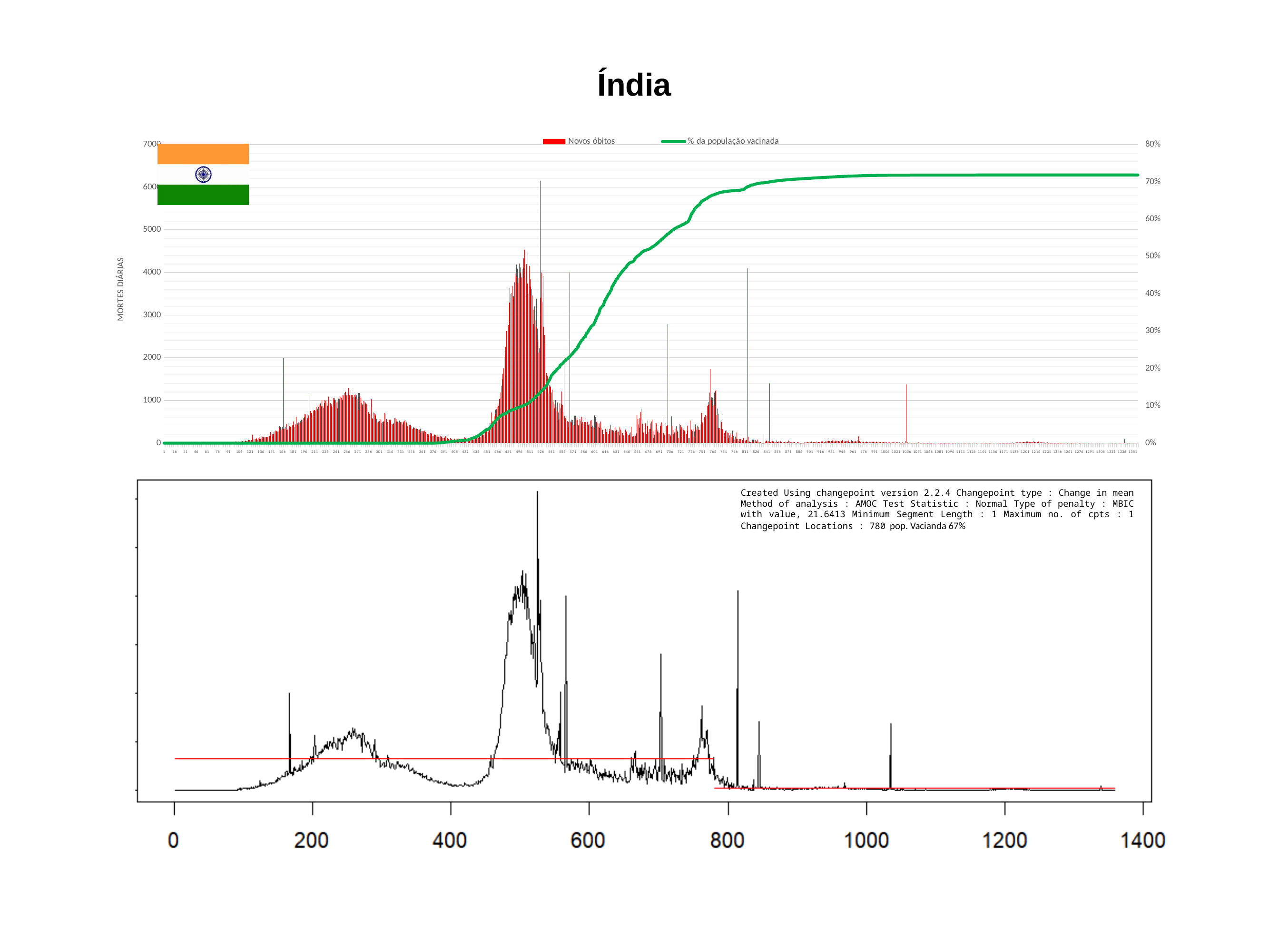
On the bottom chart, what penalty value is reported in the text box? 21.6413 On the top chart, what are the two legend entries? Novos óbitos; % da população vacinada On the bottom chart, what is the highest value shown on the horizontal axis? 1400 On the bottom chart, what percentage of the population is reported as vaccinated in the text box? 67% On the bottom chart, what changepoint location is reported in the text box? 780 On the top chart, what is the title of the left vertical axis? MORTES DIÁRIAS On the top chart, is the final value of the '% da população vacinada' line greater or less than 60%? greater On the top chart, does the green '% da população vacinada' line rise or fall along the x axis overall? rise On the top chart, what is the highest value shown on the right vertical axis? 80% On the top chart, how many series does the legend list? 2 On the top chart, what is the highest value shown on the left vertical axis? 7000 On the top chart, is the tallest 'Novos óbitos' bar greater or less than 5000? greater